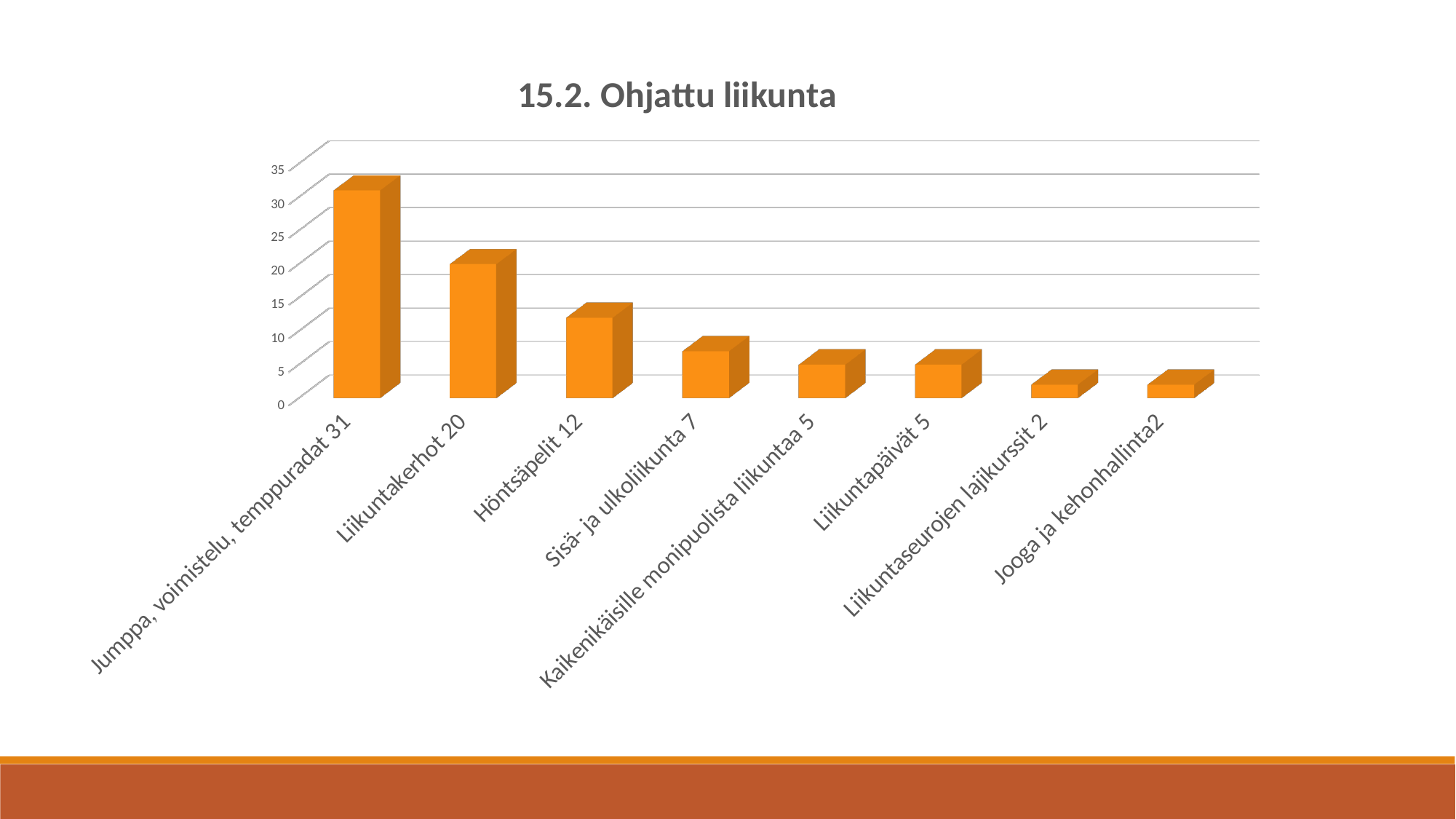
What is the title of the chart? 15.2. Ohjattu liikunta Is the value for Jumppa, voimistelu, temppuradat greater or less than 25? greater Do the values rise or fall from left to right along the x axis? fall What kind of chart is shown on the slide? bar chart What is the difference between the values for Höntsäpelit and Sisä- ja ulkoliikunta? 5 What is the value for Höntsäpelit? 12 What is the value for Sisä- ja ulkoliikunta? 7 Which category has the highest value? Jumppa, voimistelu, temppuradat Which is larger, the value for Liikuntakerhot or the value for Höntsäpelit? Liikuntakerhot What is the value for Liikuntakerhot? 20 How many categories are shown in the chart? 8 What is the difference between the values for Jumppa, voimistelu, temppuradat and Liikuntakerhot? 11